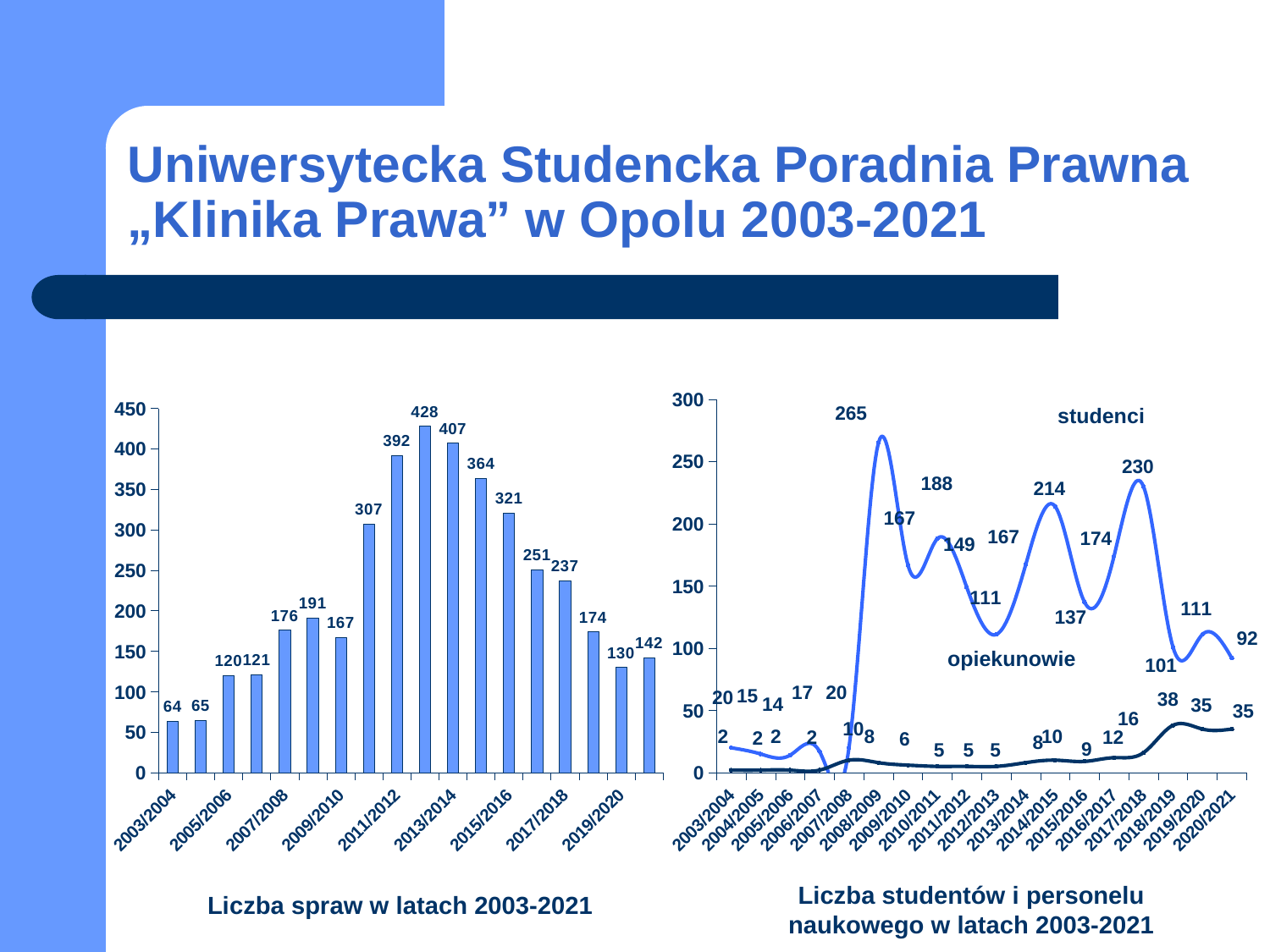
In the right chart 'Liczba studentów i personelu naukowego w latach 2003-2021', what is the highest value for studenci? 265 What kind of chart is the left chart, 'Liczba spraw w latach 2003-2021'? bar chart In the right chart 'Liczba studentów i personelu naukowego w latach 2003-2021', what is the value for opiekunowie in 2020/2021? 35 In the left chart 'Liczba spraw w latach 2003-2021', what is the difference between the values for 2013/2014 and 2015/2016? 86 In the right chart 'Liczba studentów i personelu naukowego w latach 2003-2021', what is the difference between the studenci values for 2017/2018 and 2018/2019? 129 In the left chart 'Liczba spraw w latach 2003-2021', which year has the lowest value? 2003/2004 How many bars are in the left chart 'Liczba spraw w latach 2003-2021'? 18 What kind of chart is the right chart, 'Liczba studentów i personelu naukowego w latach 2003-2021'? line chart In the left chart 'Liczba spraw w latach 2003-2021', what is the highest value shown? 428 How many series are plotted in the right chart 'Liczba studentów i personelu naukowego w latach 2003-2021'? 2 In the left chart 'Liczba spraw w latach 2003-2021', which is larger: the value for 2007/2008 or for 2009/2010? 2007/2008 In the left chart 'Liczba spraw w latach 2003-2021', what is the value for 2011/2012? 392